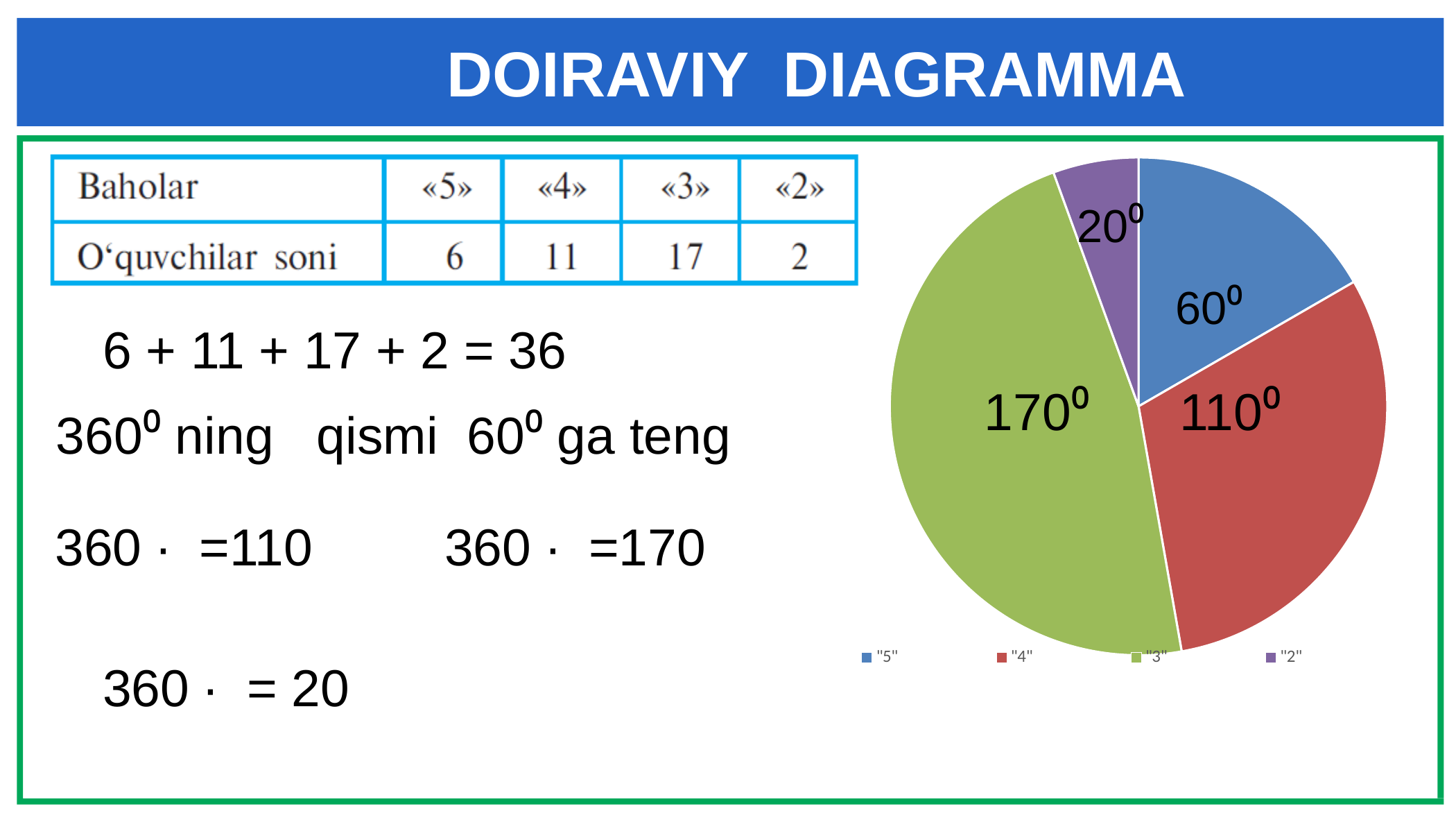
What is the value shown for the "5" slice of the pie chart? 60° What is the value shown for the "3" slice of the pie chart? 170° What colour is the "3" slice in the pie chart? green What is the value shown for the "4" slice of the pie chart? 110° Which category has the smallest slice in the pie chart? "2" What is the difference between the values of the "3" slice and the "4" slice? 60° How many entries does the legend of the pie chart list? 4 Which category has the largest slice in the pie chart? "3" What kind of chart is shown on the slide? pie chart Which slice is larger, "5" or "4"? "4" How many slices does the pie chart have? 4 What is the value shown for the "2" slice of the pie chart? 20°